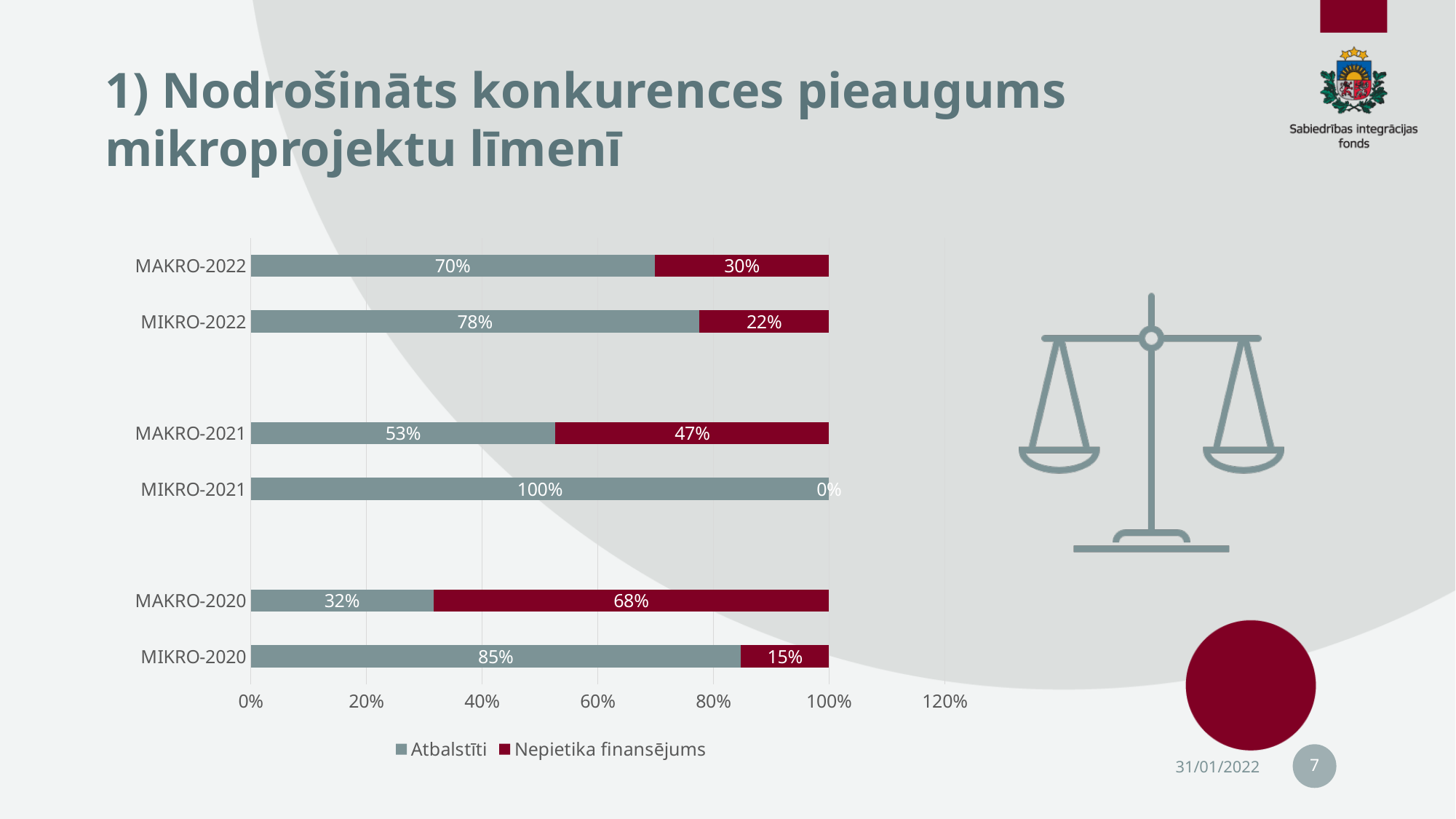
What kind of chart is shown on the slide? Stacked bar chart What is the Atbalstīti value for MIKRO-2020? 85% Which category has the highest Atbalstīti value? MIKRO-2021 Which is larger, the Atbalstīti value for MIKRO-2022 or for MAKRO-2022? MIKRO-2022 How many categories are shown on the chart? 6 What is the Nepietika finansējums value for MAKRO-2021? 47% Which category has the lowest Atbalstīti value? MAKRO-2020 What is the Nepietika finansējums value for MIKRO-2021? 0% What is the difference between the Nepietika finansējums values for MAKRO-2020 and MIKRO-2020? 53% What is the total of the stacked bar for MAKRO-2021? 100% What is the Atbalstīti value for MAKRO-2022? 70% How many series does the legend list? 2